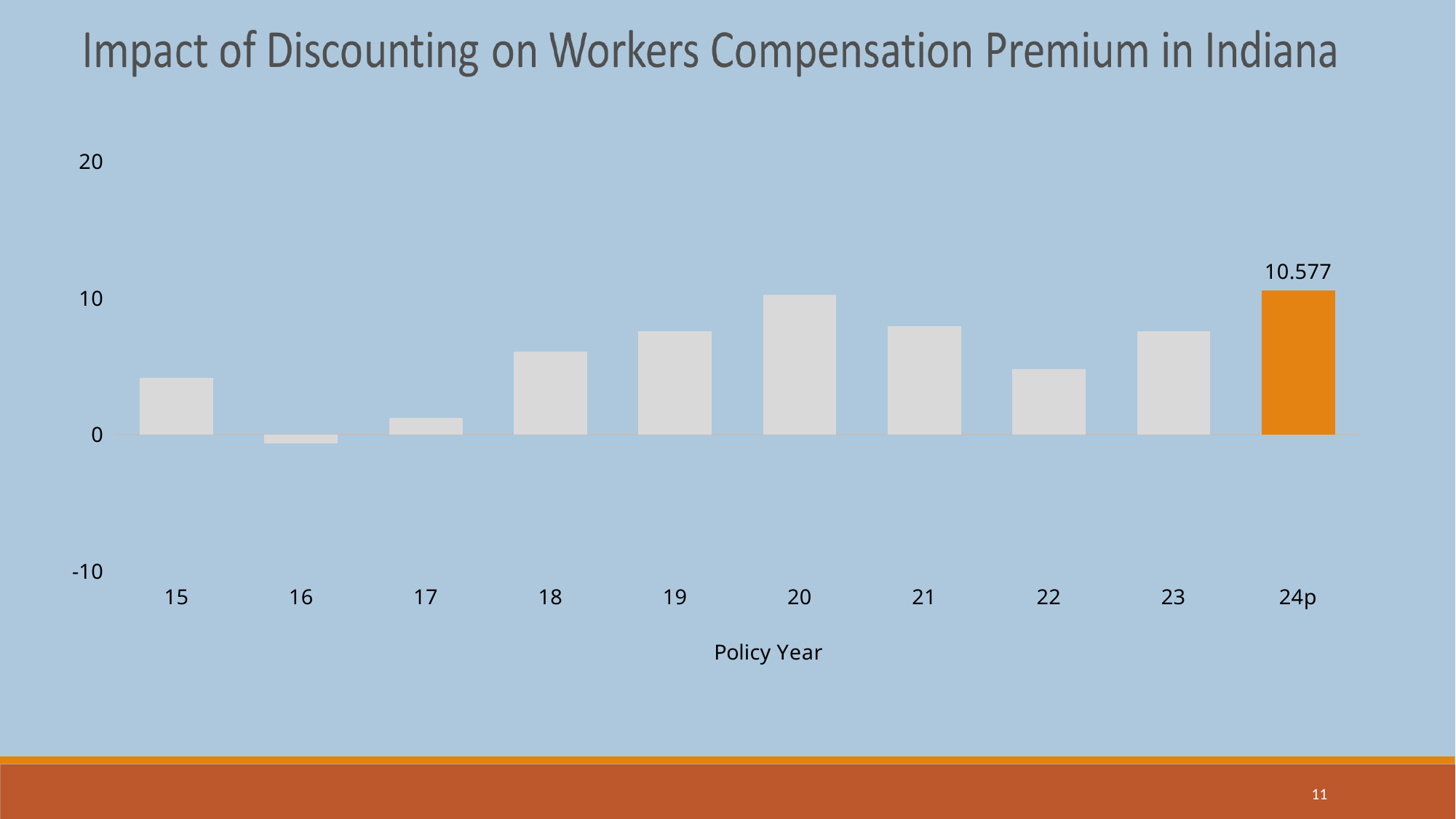
Which is larger, the value for policy year 19 or policy year 22? 19 How many policy years are shown on the x axis? 10 Is the value for policy year 18 greater or less than 10? less Which is larger, the value for policy year 17 or policy year 18? 18 Is the value for policy year 16 greater or less than 0? less Is the value for policy year 15 greater or less than 0? greater What is the title of the x axis? Policy Year What is the value for policy year 24p? 10.577 What kind of chart is shown on the slide? bar chart Which policy year has the lowest value? 16 Which policy year's bar is coloured orange? 24p